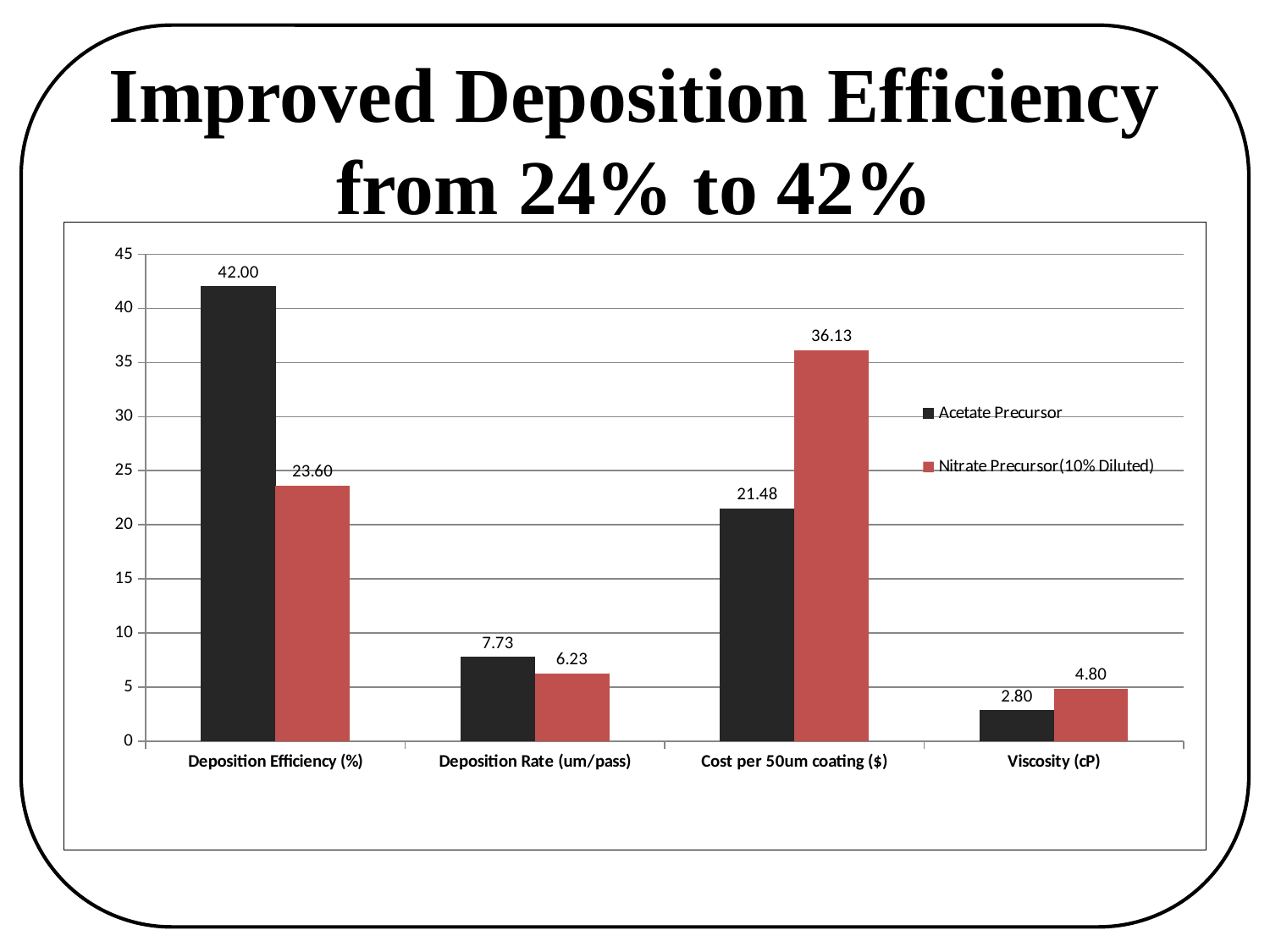
What kind of chart is shown on the slide? Bar chart How many series does the legend list? 2 What is the Viscosity (cP) value for the Acetate Precursor? 2.80 What is the Deposition Efficiency (%) value for the Acetate Precursor? 42.00 What is the difference between the Nitrate Precursor (10% Diluted) and Acetate Precursor values for Cost per 50um coating ($)? 14.65 What is the difference between the Acetate Precursor and Nitrate Precursor (10% Diluted) values for Deposition Efficiency (%)? 18.40 Which category has the highest value for the Acetate Precursor series? Deposition Efficiency (%) What is the Cost per 50um coating ($) for the Nitrate Precursor (10% Diluted)? 36.13 Which category has the lowest value for the Nitrate Precursor (10% Diluted) series? Viscosity (cP) What is the Deposition Rate (um/pass) for the Nitrate Precursor (10% Diluted)? 6.23 How many categories are shown on the x axis? 4 For Deposition Rate (um/pass), which series has the larger value? Acetate Precursor